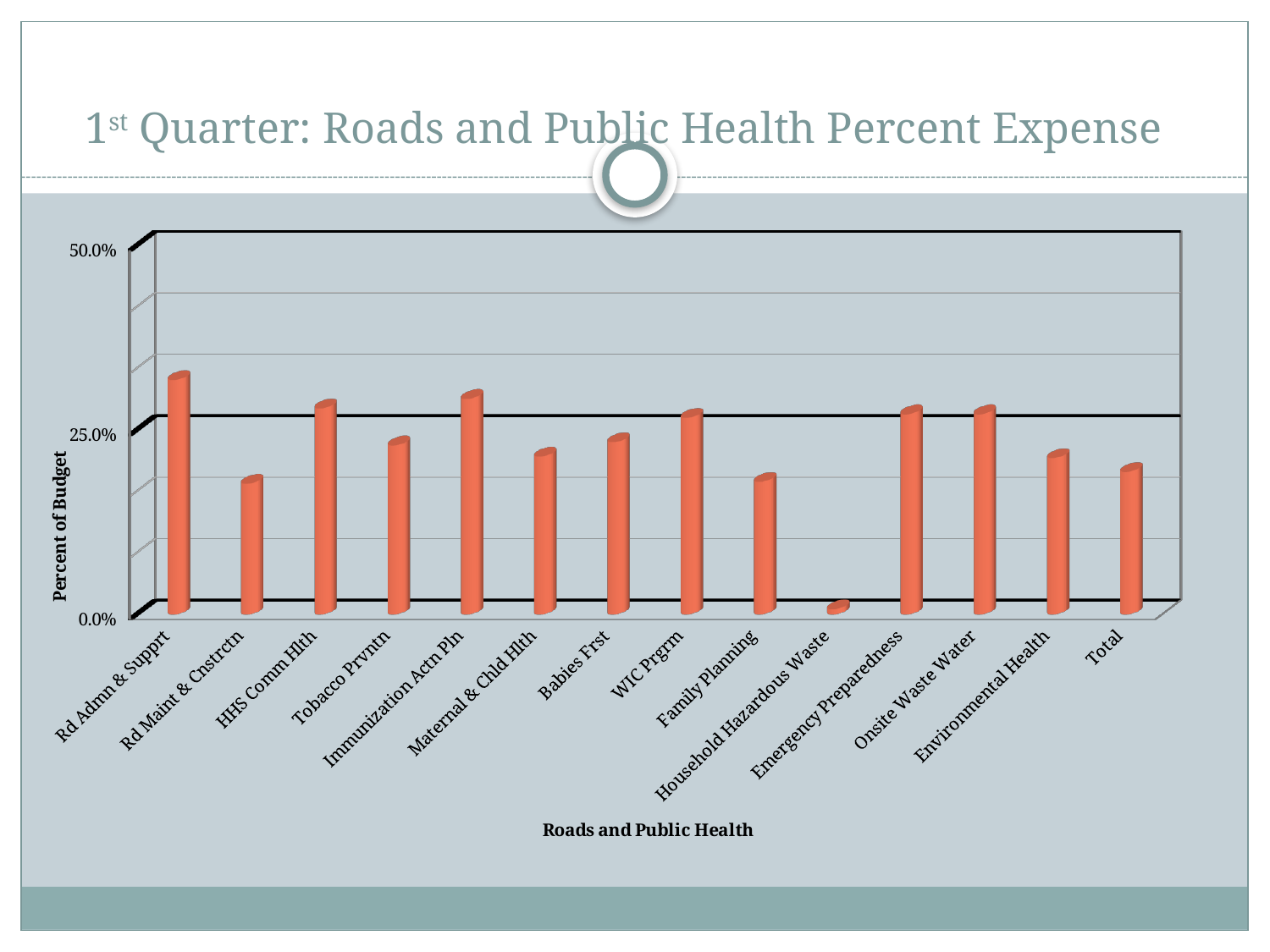
What kind of chart is shown on the slide? Bar chart What is the title of the horizontal axis? Roads and Public Health What is the title of the vertical axis? Percent of Budget Is the value for Rd Admn & Supprt greater or less than 25.0%? greater Is the value for Immunization Actn Pln greater or less than 25.0%? greater How many categories are plotted along the x axis? 14 Which category has the lowest percent of budget? Household Hazardous Waste Is the value for Total greater or less than 25.0%? less Which is larger, the value for Immunization Actn Pln or the value for Maternal & Chld Hlth? Immunization Actn Pln Which category has the highest percent of budget? Rd Admn & Supprt Which is larger, the value for Rd Admn & Supprt or the value for Rd Maint & Cnstrctn? Rd Admn & Supprt